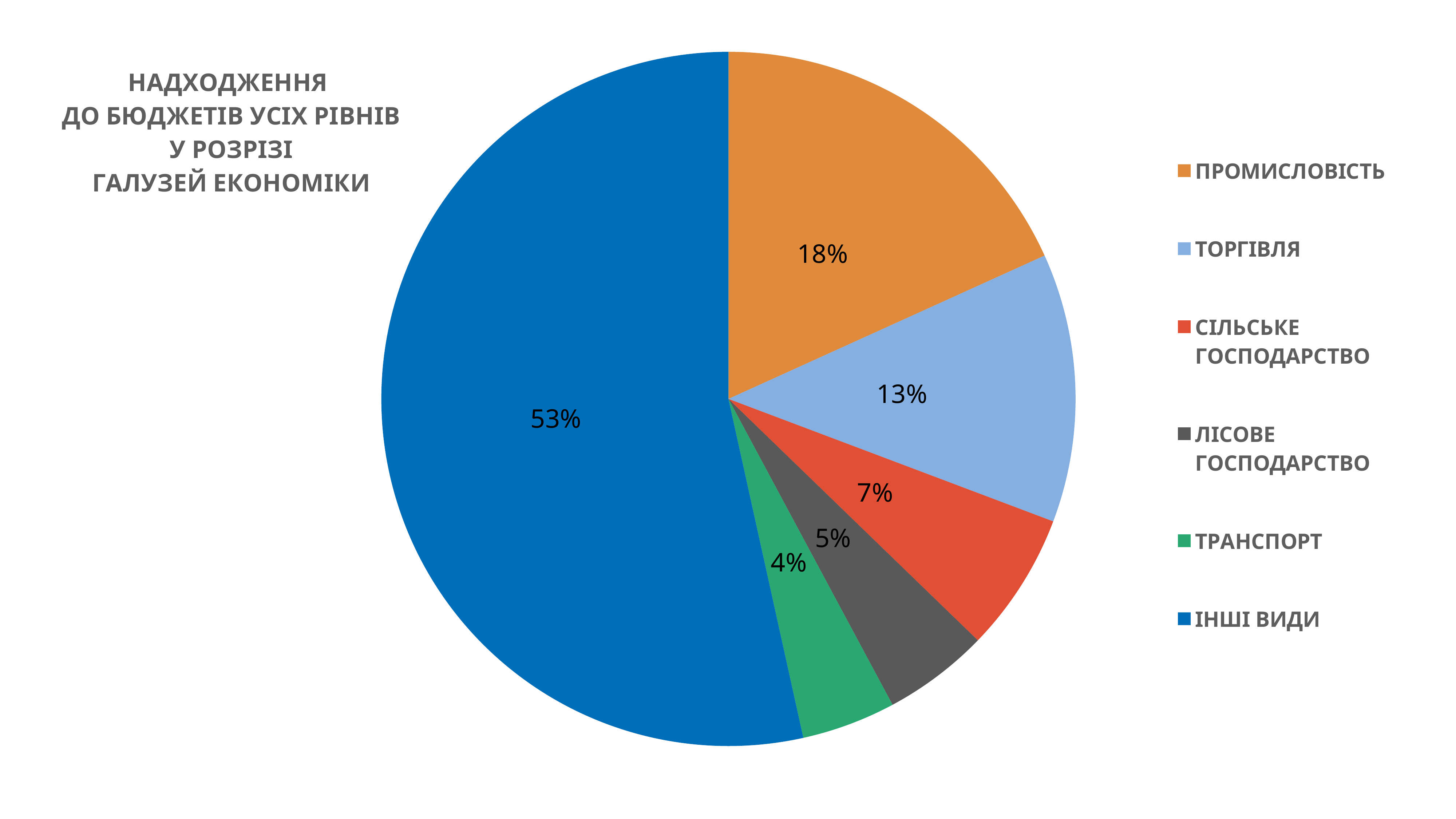
What kind of chart is shown on the slide? Pie chart What is the value shown for ТРАНСПОРТ? 4% What is the value shown for СІЛЬСЬКЕ ГОСПОДАРСТВО? 7% How many categories does the legend list? 6 What is the value shown for ЛІСОВЕ ГОСПОДАРСТВО? 5% What colour is the slice for ІНШІ ВИДИ? Blue What share of the pie does ТОРГІВЛЯ have? 13% What share of the pie does ПРОМИСЛОВІСТЬ have? 18% Which category has the largest slice of the pie? ІНШІ ВИДИ What is the difference in percentage points between ІНШІ ВИДИ and ПРОМИСЛОВІСТЬ? 35 Which is larger, the slice for ТОРГІВЛЯ or the slice for СІЛЬСЬКЕ ГОСПОДАРСТВО? ТОРГІВЛЯ Which category has the smallest slice of the pie? ТРАНСПОРТ